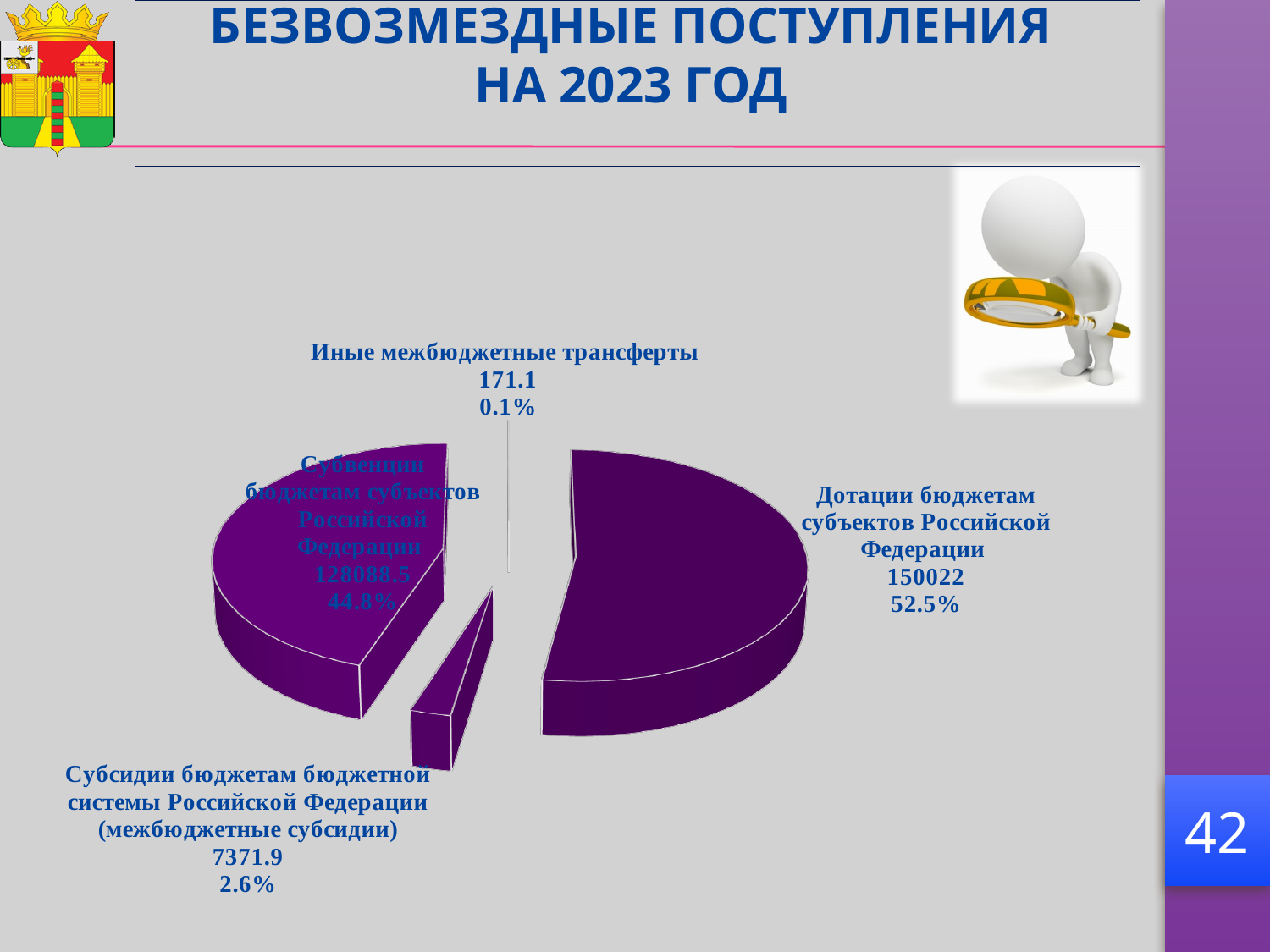
What is the value for Субсидии бюджетам бюджетной системы Российской Федерации (межбюджетные субсидии)? 7371.9 What is the value for Субвенции бюджетам субъектов Российской Федерации? 128088.5 What share of the pie does Дотации бюджетам субъектов Российской Федерации represent? 52.5% What is the title of the slide containing the chart? БЕЗВОЗМЕЗДНЫЕ ПОСТУПЛЕНИЯ НА 2023 ГОД How many categories are shown in the pie chart? 4 What is the value for Дотации бюджетам субъектов Российской Федерации? 150022 What is the value for Иные межбюджетные трансферты? 171.1 What is the difference between the values for Дотации бюджетам субъектов Российской Федерации and Субвенции бюджетам субъектов Российской Федерации? 21933.5 What share of the pie does Субвенции бюджетам субъектов Российской Федерации represent? 44.8% What kind of chart is shown on the slide? pie chart Which category has the largest slice of the pie? Дотации бюджетам субъектов Российской Федерации Which category has the smallest slice of the pie? Иные межбюджетные трансферты